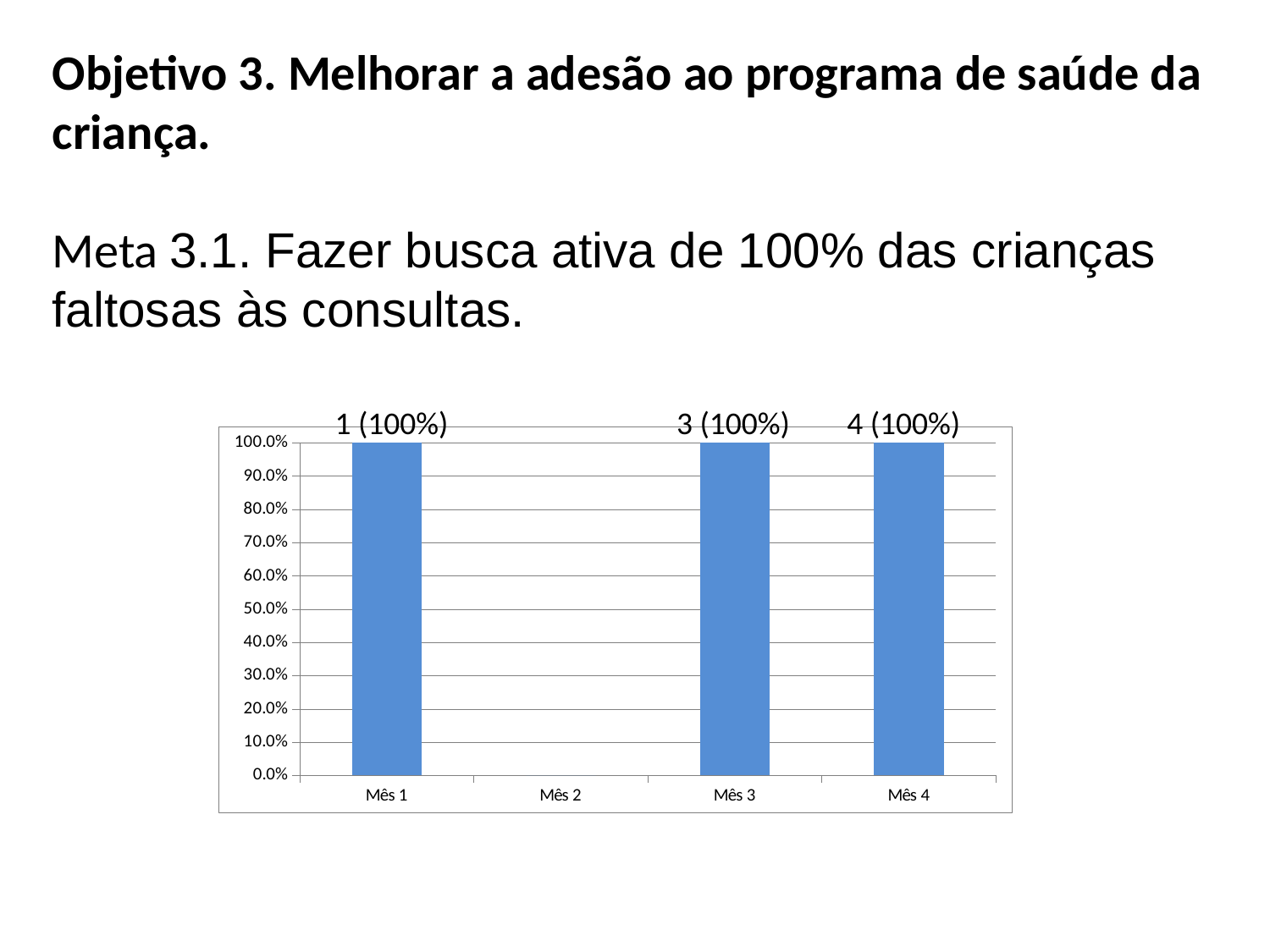
What percentage does the bar for Mês 4 reach? 100% What is the data label shown above the bar for Mês 3? 3 (100%) How many categories are shown on the x axis of the chart? 4 What is the data label shown above the bar for Mês 4? 4 (100%) Is the value for Mês 1 greater or less than 90.0%? greater What kind of chart is shown on the slide? bar chart What colour are the bars in the chart? blue Which is larger, the value for Mês 1 or the value for Mês 2? Mês 1 What is the highest tick value shown on the y axis of the chart? 100.0% What is the data label shown above the bar for Mês 1? 1 (100%) Is the value for Mês 3 greater or less than 50.0%? greater Which category has the lowest value in the chart? Mês 2